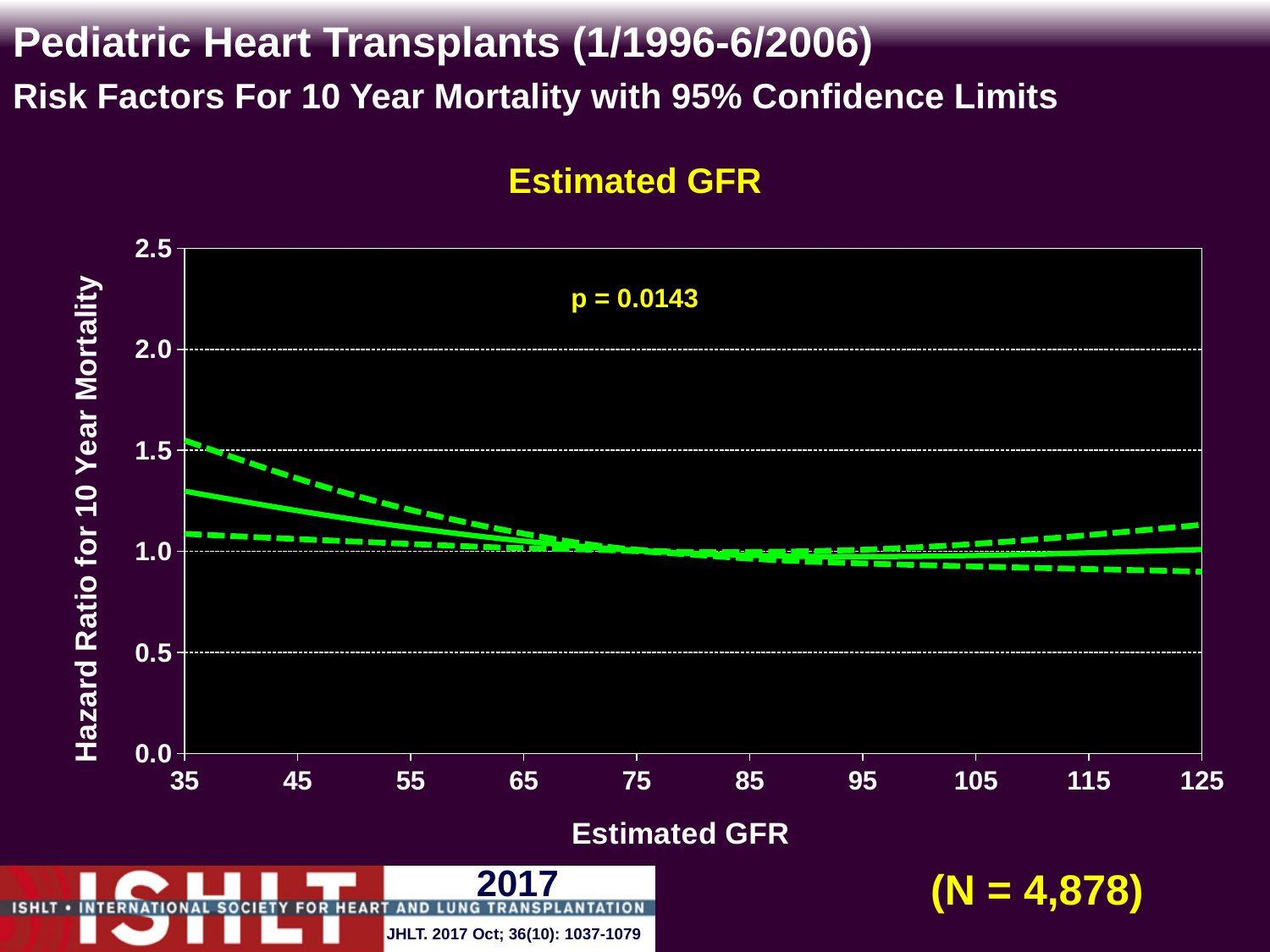
Is the solid hazard ratio line at an Estimated GFR of 35 greater or less than 1.0? greater What is the highest value shown on the y-axis? 2.5 Is the lower dashed confidence limit at an Estimated GFR of 125 greater or less than 1.0? less What kind of chart is shown on the slide? line chart Is the upper dashed confidence limit at an Estimated GFR of 125 greater or less than 1.0? greater What is the title of the chart? Estimated GFR Does the solid hazard ratio line rise or fall as Estimated GFR increases from 35 to 75? fall How many lines are plotted on the chart? 3 What sample size (N) is shown on the slide? N = 4,878 What p-value is printed on the chart? p = 0.0143 What is the y-axis label of the chart? Hazard Ratio for 10 Year Mortality